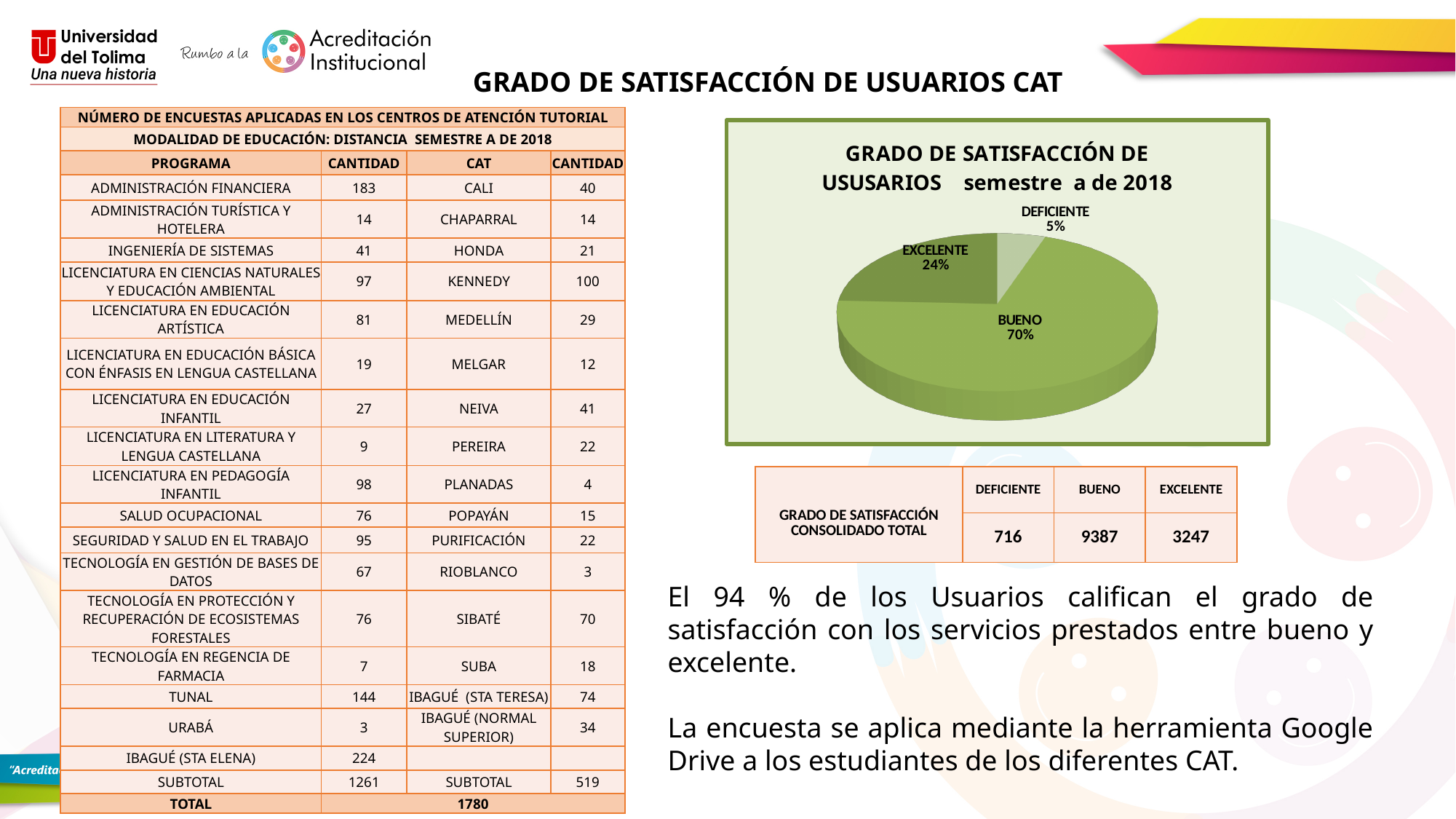
What type of chart is shown on the slide? Pie chart What is the title of the pie chart? GRADO DE SATISFACCIÓN DE USUSARIOS semestre a de 2018 How many slices does the pie chart have? 3 Which slice is larger in the pie chart, EXCELENTE or DEFICIENTE? EXCELENTE What share of the pie does the BUENO slice represent? 70% What is the difference in percentage points between the BUENO and EXCELENTE slices? 46 What percentage of the pie chart is labelled DEFICIENTE? 5% Which category has the smallest slice in the pie chart? DEFICIENTE What is the difference in percentage points between the EXCELENTE and DEFICIENTE slices? 19 What percentage of the pie chart is labelled EXCELENTE? 24% What percentage of the pie chart is labelled BUENO? 70% Which category has the largest slice in the pie chart? BUENO